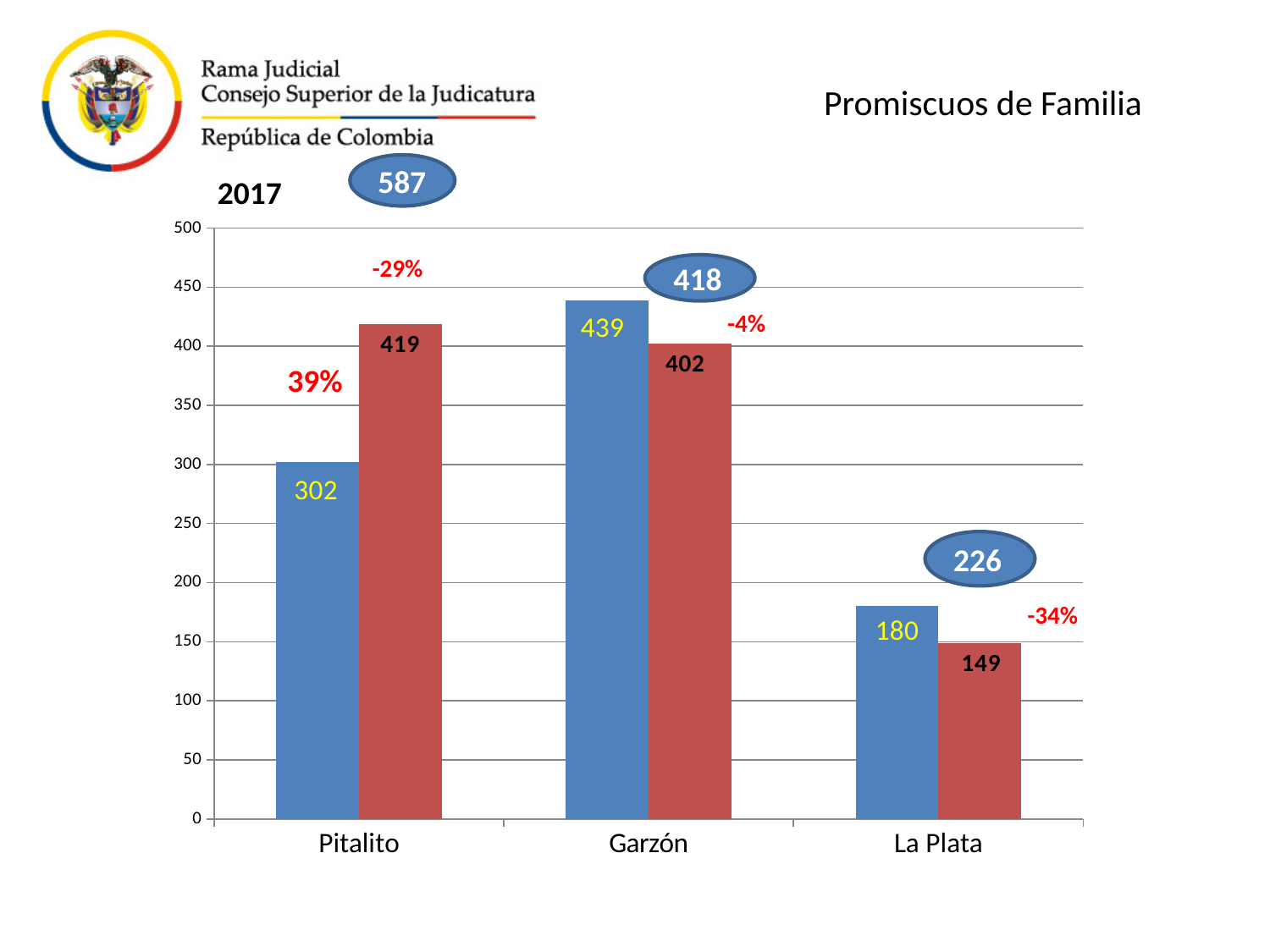
How many categories are shown on the x axis? 3 For Garzón, which is larger, the blue bar or the red bar? the blue bar What is the value of the red bar for Pitalito? 419 What kind of chart is shown on the slide? bar chart What percentage is shown in red above the red bar for La Plata? -34% What is the difference between the red bar and the blue bar for Pitalito? 117 What is the value of the blue bar for Pitalito? 302 What is the value of the red bar for Garzón? 402 Which category has the highest blue bar? Garzón Which category has the lowest red bar? La Plata What number is shown in the blue oval above the Garzón bars? 418 What is the value of the blue bar for La Plata? 180